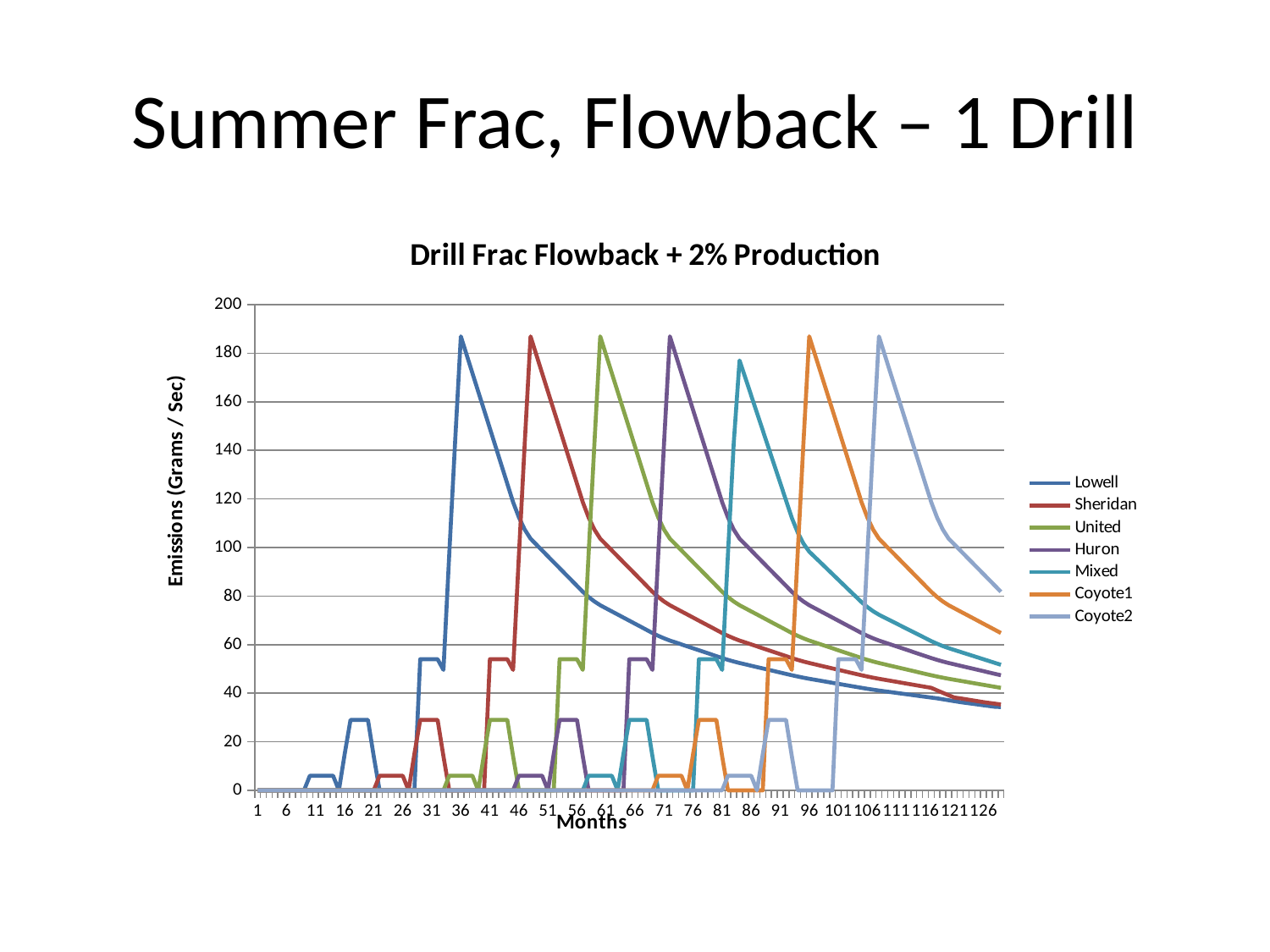
How many series does the legend list? 7 Which series reaches its peak earliest along the Months axis? Lowell What kind of chart is shown on the slide? line chart Is the value of the Coyote2 series at month 126 greater or less than 60? greater What is the title of the chart? Drill Frac Flowback + 2% Production After the Sheridan series reaches its peak, do its values rise or fall as months increase? fall At month 126, which series has the larger value, Coyote2 or Lowell? Coyote2 Is the value of the Lowell series at month 126 greater or less than 40? less Is the peak value of the Lowell series greater or less than 180? greater Which series reaches its peak latest along the Months axis? Coyote2 What is the label of the vertical axis? Emissions (Grams / Sec)